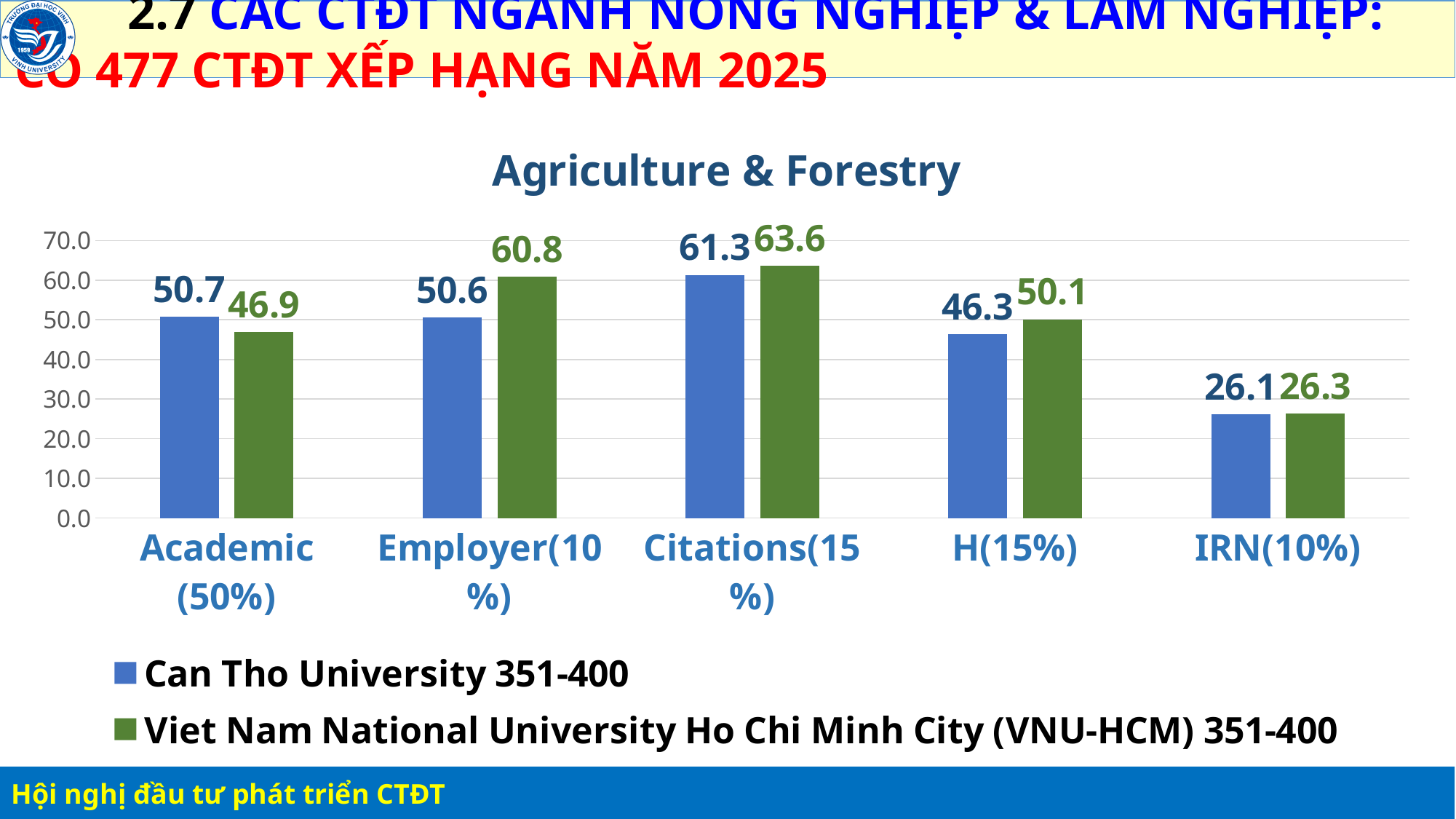
What is the value for Viet Nam National University Ho Chi Minh City (VNU-HCM) in the Employer (10%) category? 60.8 In which category does Can Tho University have its highest value? Citations(15%) What is the difference between the VNU-HCM and Can Tho University values in the Employer (10%) category? 10.2 Which university has the larger value in the Academic (50%) category? Can Tho University In which category does VNU-HCM have its lowest value? IRN(10%) Is the value for Can Tho University in the IRN (10%) category greater or less than 30.0? less What is the value for VNU-HCM in the H (15%) category? 50.1 What kind of chart is shown on the slide? bar chart How many series does the legend list? 2 What is the value for Can Tho University in the Citations (15%) category? 61.3 What is the value for Can Tho University in the Academic (50%) category? 50.7 How many categories are shown on the x axis? 5